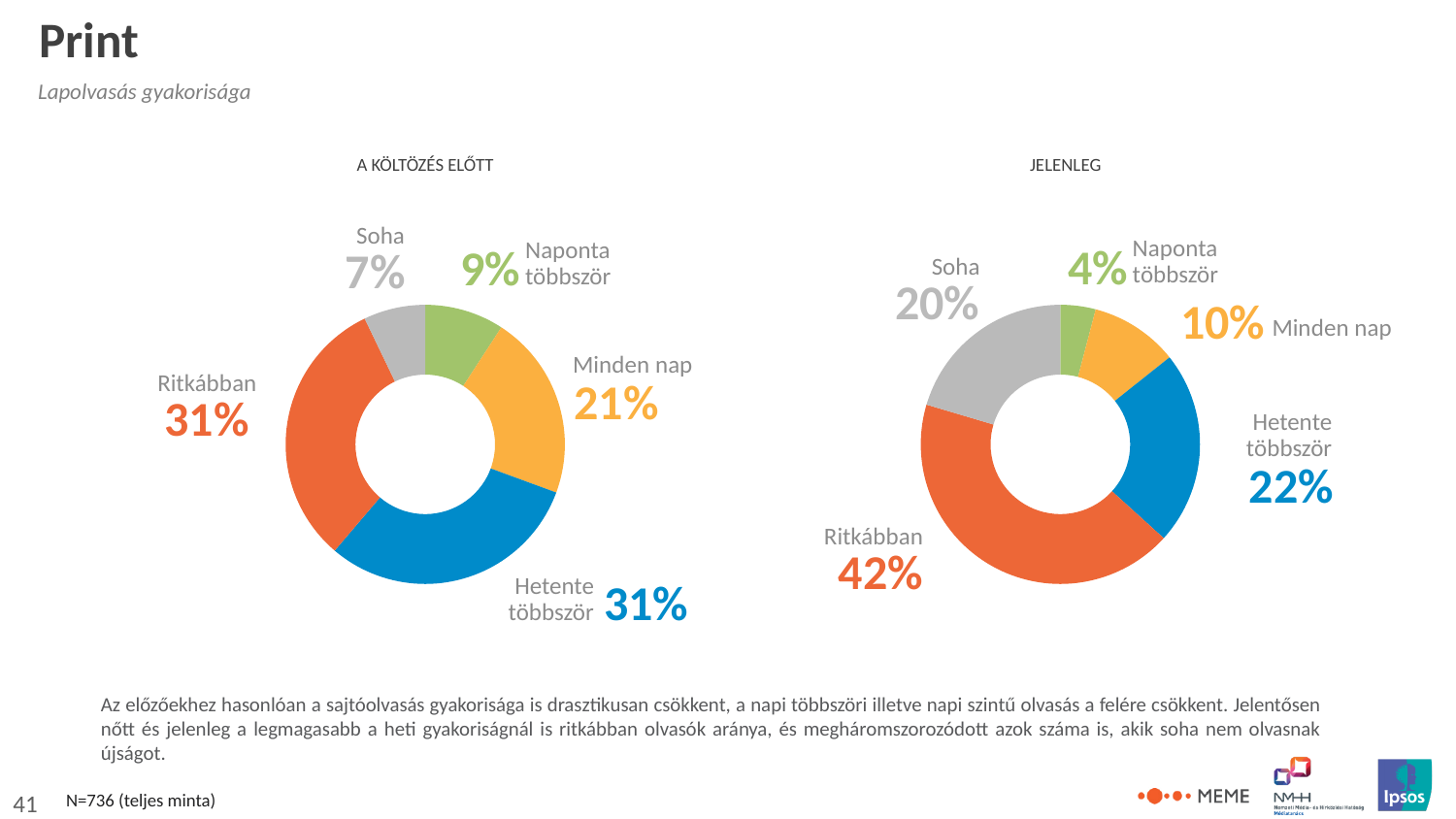
In the "A KÖLTÖZÉS ELŐTT" chart, which category has the smallest share? Soha In the "JELENLEG" chart, what is the value for Hetente többször? 22% In the "A KÖLTÖZÉS ELŐTT" chart, what is the value for Soha? 7% What type of chart is used on this slide? Donut (pie) chart How many categories does the "JELENLEG" chart show? 5 In the "A KÖLTÖZÉS ELŐTT" chart, what is the value for Minden nap? 21% In the "JELENLEG" chart, which category has the largest share? Ritkábban Which is larger: Soha in the "JELENLEG" chart or Soha in the "A KÖLTÖZÉS ELŐTT" chart? Soha in the "JELENLEG" chart In the "A KÖLTÖZÉS ELŐTT" chart, what is the difference between Minden nap and Naponta többször? 12 percentage points In the "JELENLEG" chart, what is the value for Ritkábban? 42% In the "JELENLEG" chart, which category has the smallest share? Naponta többször What is the difference between the Ritkábban value in the "JELENLEG" chart and the Ritkábban value in the "A KÖLTÖZÉS ELŐTT" chart? 11 percentage points